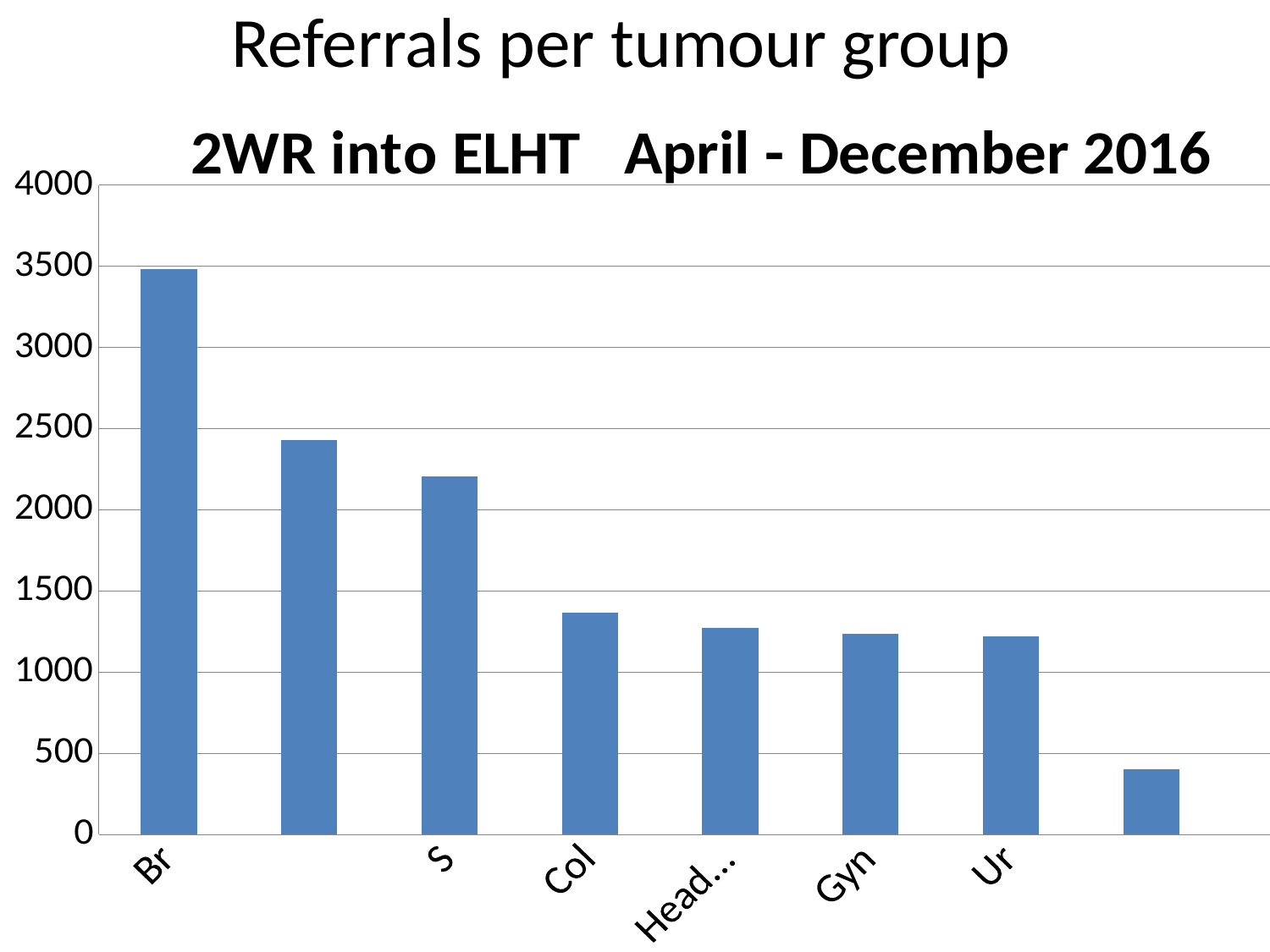
Is the value for Br greater or less than 3000? greater Which tumour group has the highest number of referrals? Br How many bars are plotted in the chart? 8 Is the value for Gyn greater or less than 1000? greater Is the value for Ur greater or less than 1500? less Which has more referrals, Col or Gyn? Col Which has more referrals, Br or S? Br What is the highest value shown on the vertical axis? 4000 What kind of chart is shown on the slide? bar chart Do the bar values rise or fall from left to right across the chart? fall